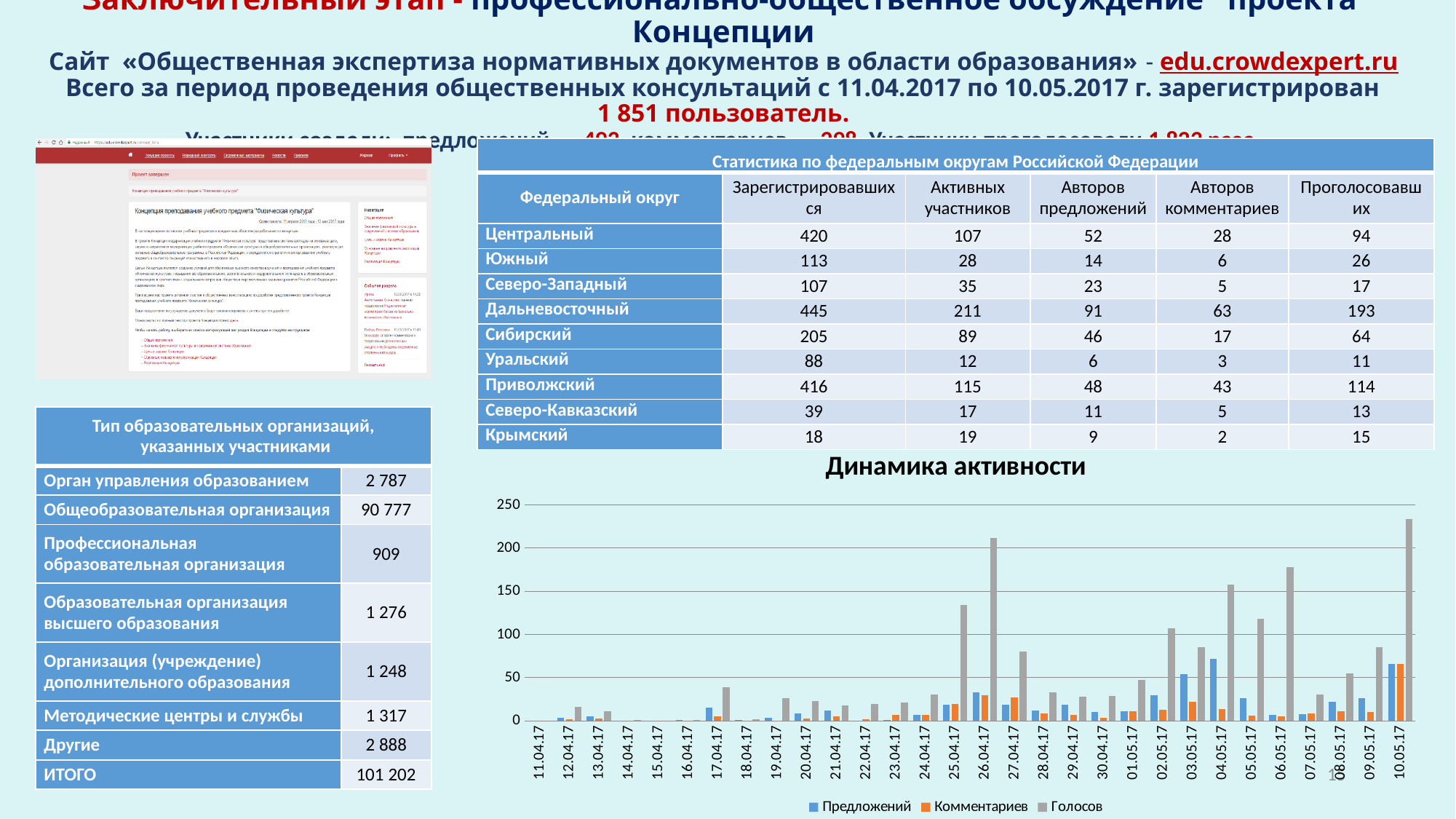
In the "Динамика активности" chart, which is larger: the Голосов value for 26.04.17 or for 27.04.17? 26.04.17 In the "Динамика активности" chart, is the Голосов value for 17.04.17 greater or less than 50? less In the "Динамика активности" chart, on which date is the Голосов value highest? 10.05.17 In the "Динамика активности" chart, do the Голосов values generally rise or fall from 11.04.17 to 10.05.17? rise In the "Динамика активности" chart, is the Голосов value for 10.05.17 greater or less than 200? greater What is the title of the bar chart on the slide? Динамика активности What colour represents the Голосов series in the "Динамика активности" chart? grey In the "Динамика активности" chart, is the Голосов value for 06.05.17 greater or less than 150? greater How many dates are shown on the x axis of the "Динамика активности" chart? 30 What kind of chart is "Динамика активности"? bar chart How many series does the legend of the "Динамика активности" chart list? 3